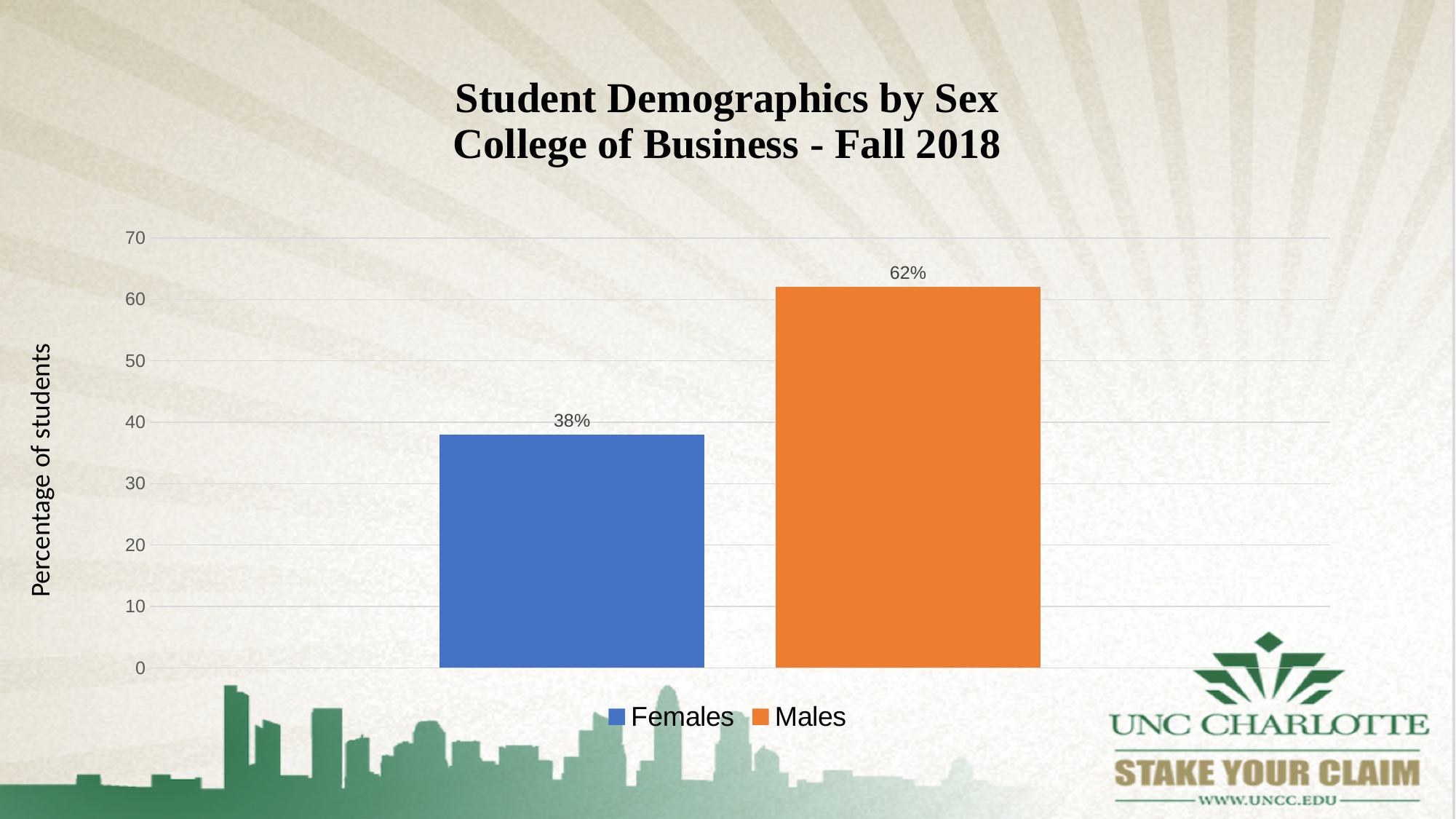
What is the title of the chart? Student Demographics by Sex College of Business - Fall 2018 Which group has the higher percentage of students? Males What percentage of students are Females? 38% What kind of chart is shown on the slide? bar chart Is the value for Males greater or less than 60? greater Is the value for Females greater or less than 40? less What is the label of the vertical axis? Percentage of students Which group has the lower percentage of students? Females Is the value for Males larger than the value for Females? Yes What is the difference in percentage points between Males and Females? 24 How many series does the legend list? 2 What percentage of students are Males? 62%